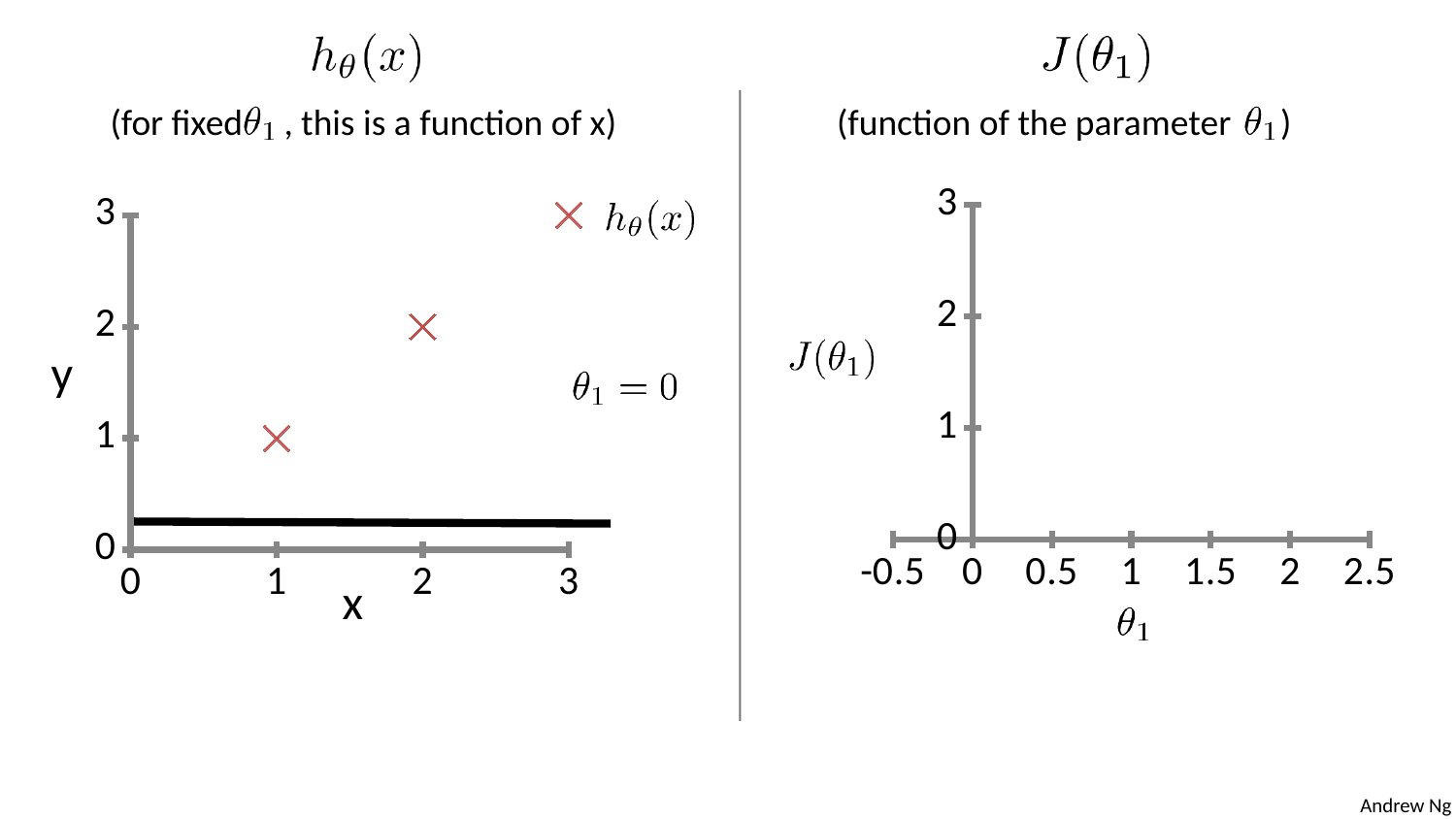
In the left chart titled hθ(x), do the y values of the data points rise or fall as x increases? rise In the right chart titled J(θ1), what is the label of the horizontal axis? θ1 In the left chart titled hθ(x), what is the difference between the y values of the points at x = 2 and x = 1? 1 In the left chart titled hθ(x), is the value of the black line at x = 1 greater or less than 1? less In the left chart titled hθ(x), which data point has the larger y value, the one at x = 1 or the one at x = 2? x = 2 In the left chart titled hθ(x), what value of θ1 is written on the chart? θ1 = 0 In the right chart titled J(θ1), how many data points are plotted? 0 In the right chart titled J(θ1), what is the lowest tick value shown on the horizontal axis? -0.5 In the left chart titled hθ(x), what is the y value of the data point at x = 2? 2 In the right chart titled J(θ1), what is the highest tick value shown on the horizontal axis? 2.5 In the left chart titled hθ(x), what is the y value of the data point at x = 1? 1 What kind of chart is the left chart titled hθ(x)? scatter plot